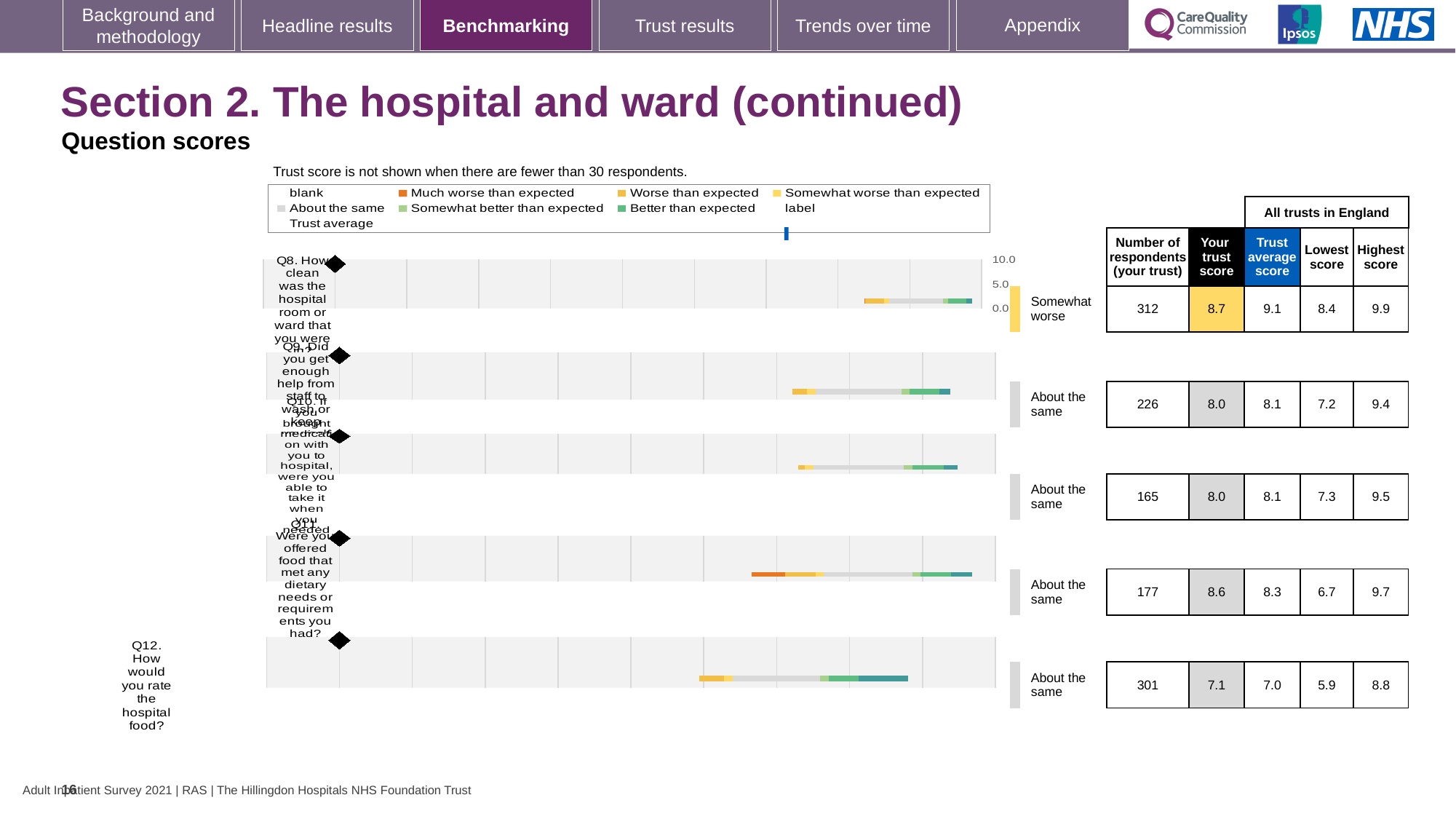
What kind of chart is used to show the question scores on this slide? bar chart For Q8, which is larger: the 'Your trust score' or the trust average score? Trust average score Which question has the lowest 'Your trust score'? Q12 What is the number of respondents for Q12 (How would you rate the hospital food)? 301 Which benchmark category is shown for Q8? Somewhat worse What is the difference between the highest score (8.8) and the lowest score (5.9) for Q12? 2.9 What is the difference between the 'Your trust score' and the trust average score for Q12? 0.1 How many questions (Q8 to Q12) are plotted in the chart? 5 What is the highest score across all trusts in England for Q8? 9.9 What is the 'Your trust score' for Q8 (How clean was the hospital room or ward)? 8.7 Which question has the highest 'Your trust score'? Q8 What is the trust average score for Q11 (Were you offered food that met any dietary needs or requirements you had)? 8.3